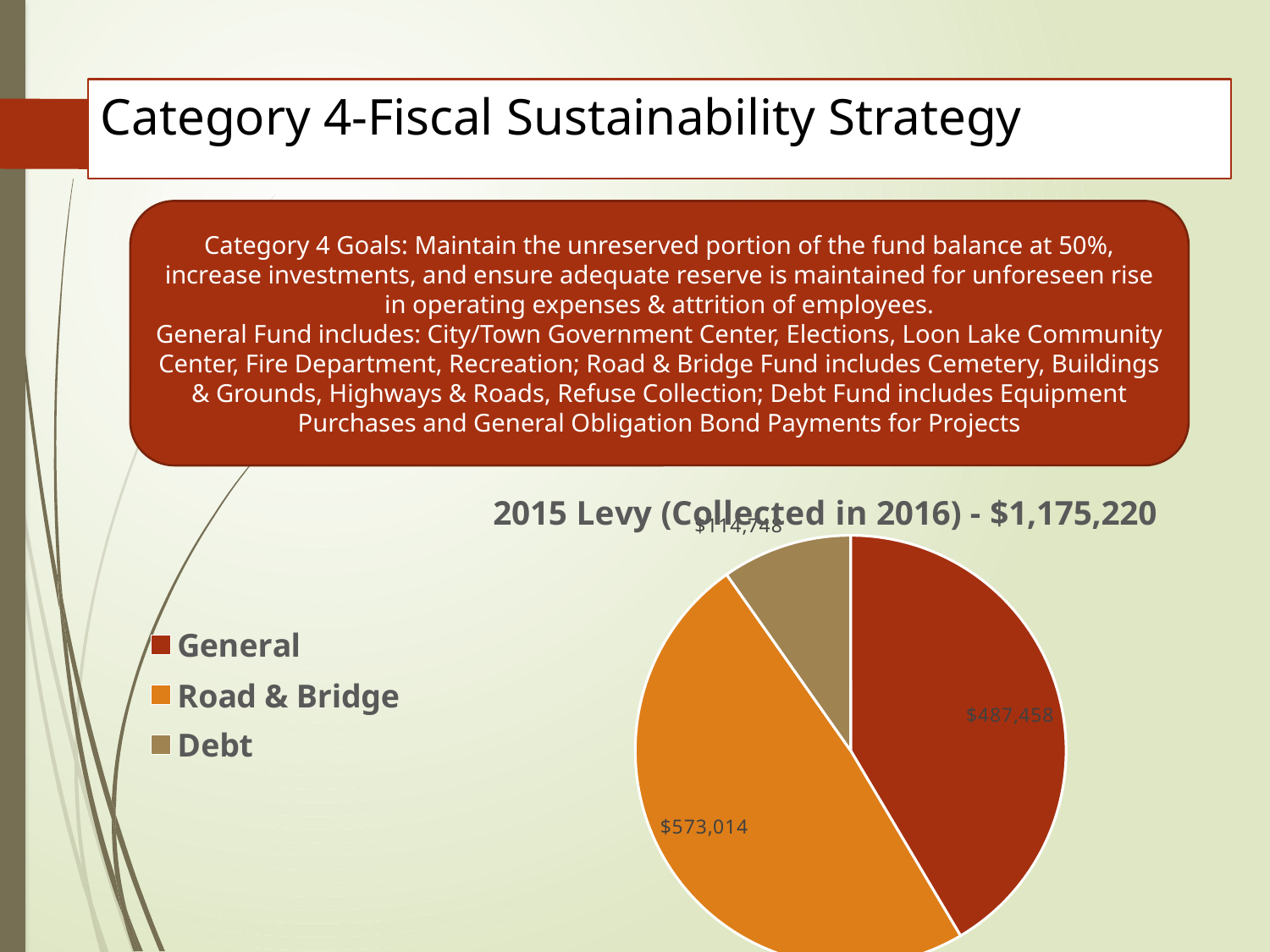
Which is larger, the General slice or the Road & Bridge slice? Road & Bridge What is the value shown for the General slice of the pie chart? $487,458 What is the value shown for the Debt slice of the pie chart? $114,748 How many slices does the pie chart have? 3 What kind of chart is shown on the slide? Pie chart How many entries does the chart legend list? 3 What colour is the Road & Bridge slice in the pie chart? Orange What is the value shown for the Road & Bridge slice of the pie chart? $573,014 What is the difference between the Road & Bridge value and the General value? $85,556 Which category has the smallest slice of the pie chart? Debt What is the title of the chart? 2015 Levy (Collected in 2016) - $1,175,220 Which category has the largest slice of the pie chart? Road & Bridge